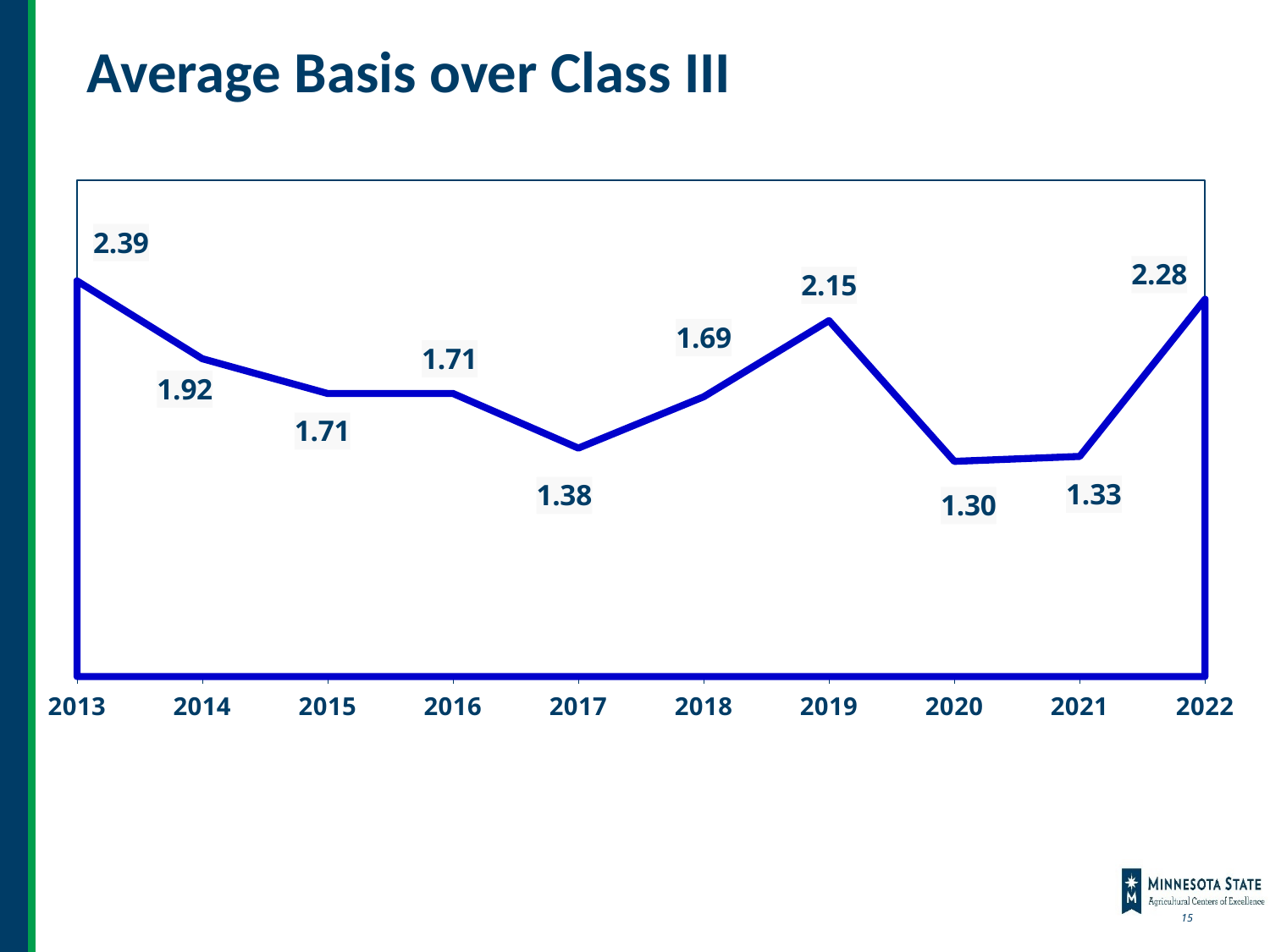
Which year has the highest average basis over Class III? 2013 What kind of chart is shown on the slide? line chart What is the average basis over Class III for 2013? 2.39 How many years are plotted on the chart? 10 What is the value shown for 2019? 2.15 What is the difference between the values for 2022 and 2021? 0.95 Do the values rise or fall from 2013 to 2017? fall Which year has the lowest average basis over Class III? 2020 What is the value shown for 2022? 2.28 What is the value shown for 2017? 1.38 What is the difference between the values for 2013 and 2020? 1.09 Which year has the larger value, 2014 or 2018? 2014